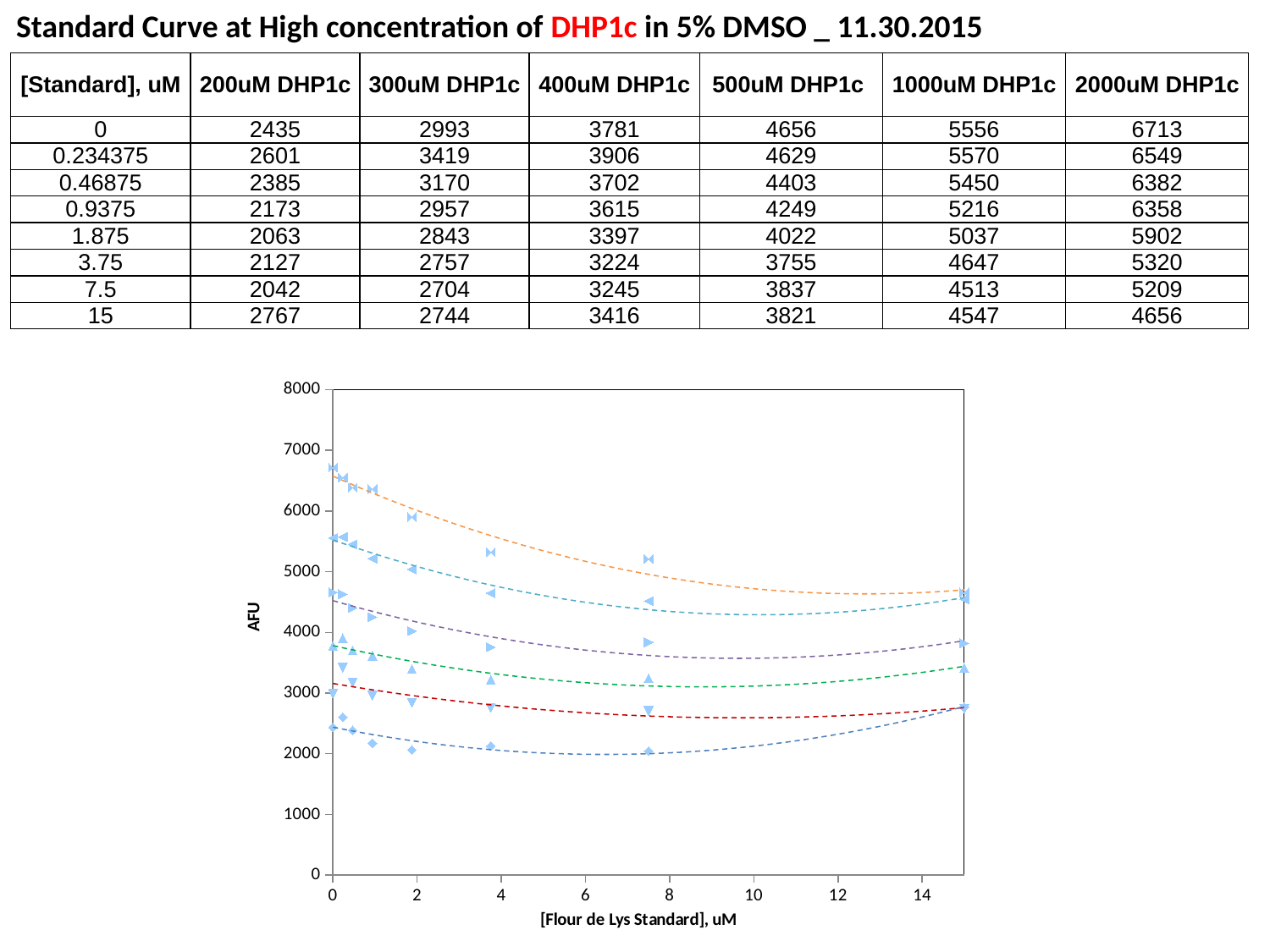
What is the label of the x axis of the chart? [Flour de Lys Standard], uM What kind of chart is shown on the slide? scatter chart What is the AFU value for 200uM DHP1c at a standard concentration of 15 uM? 2767 How many data series (DHP1c concentrations) are plotted in the chart? 6 What is the AFU value for 2000uM DHP1c at a standard concentration of 0 uM? 6713 Is the value of the lowest series at a standard concentration of 0 uM greater or less than 3000 AFU? less Which DHP1c concentration has the highest AFU value at a standard concentration of 0 uM? 2000uM DHP1c How many standard concentration points are plotted for each series? 8 What is the label of the y axis of the chart? AFU Is the value of the topmost series at a standard concentration of 0 uM greater or less than 6000 AFU? greater Does the topmost series generally rise or fall as the standard concentration increases from 0 to 15 uM? fall Is the value of the topmost series at a standard concentration of 15 uM greater or less than 5000 AFU? less